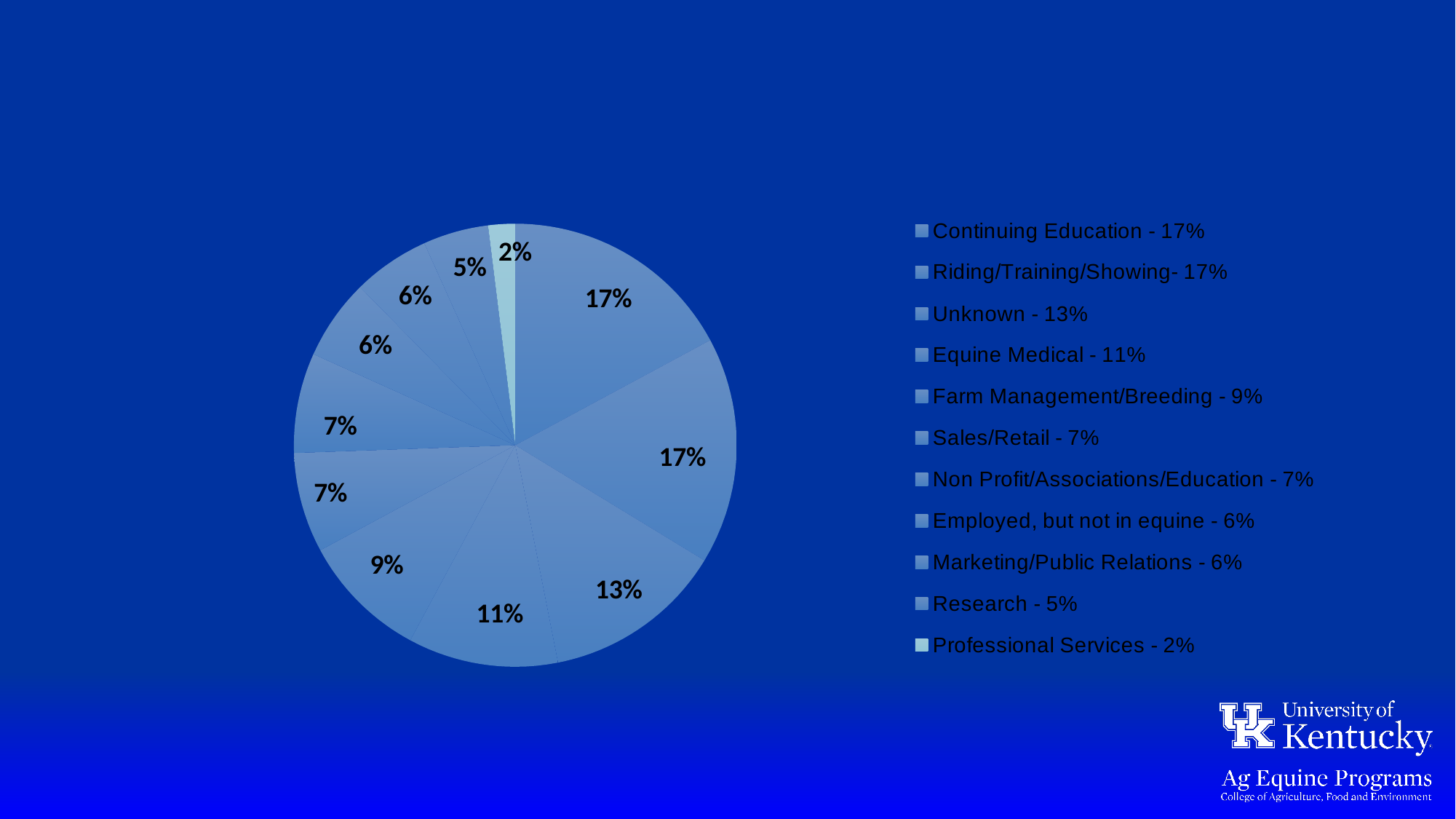
Which category has the smallest slice of the pie? Professional Services What is the value for Farm Management/Breeding? 9% How many entries does the legend list? 11 What is the value for Employed, but not in equine? 6% What share of the pie does Unknown represent? 13% How many slices does the pie chart have? 11 What kind of chart is shown on the slide? pie chart What is the value for Research? 5% What is the difference between the Continuing Education share and the Unknown share? 4% What is the difference between Equine Medical and Professional Services? 9% What is the value for Equine Medical? 11% Which is larger, Sales/Retail or Research? Sales/Retail